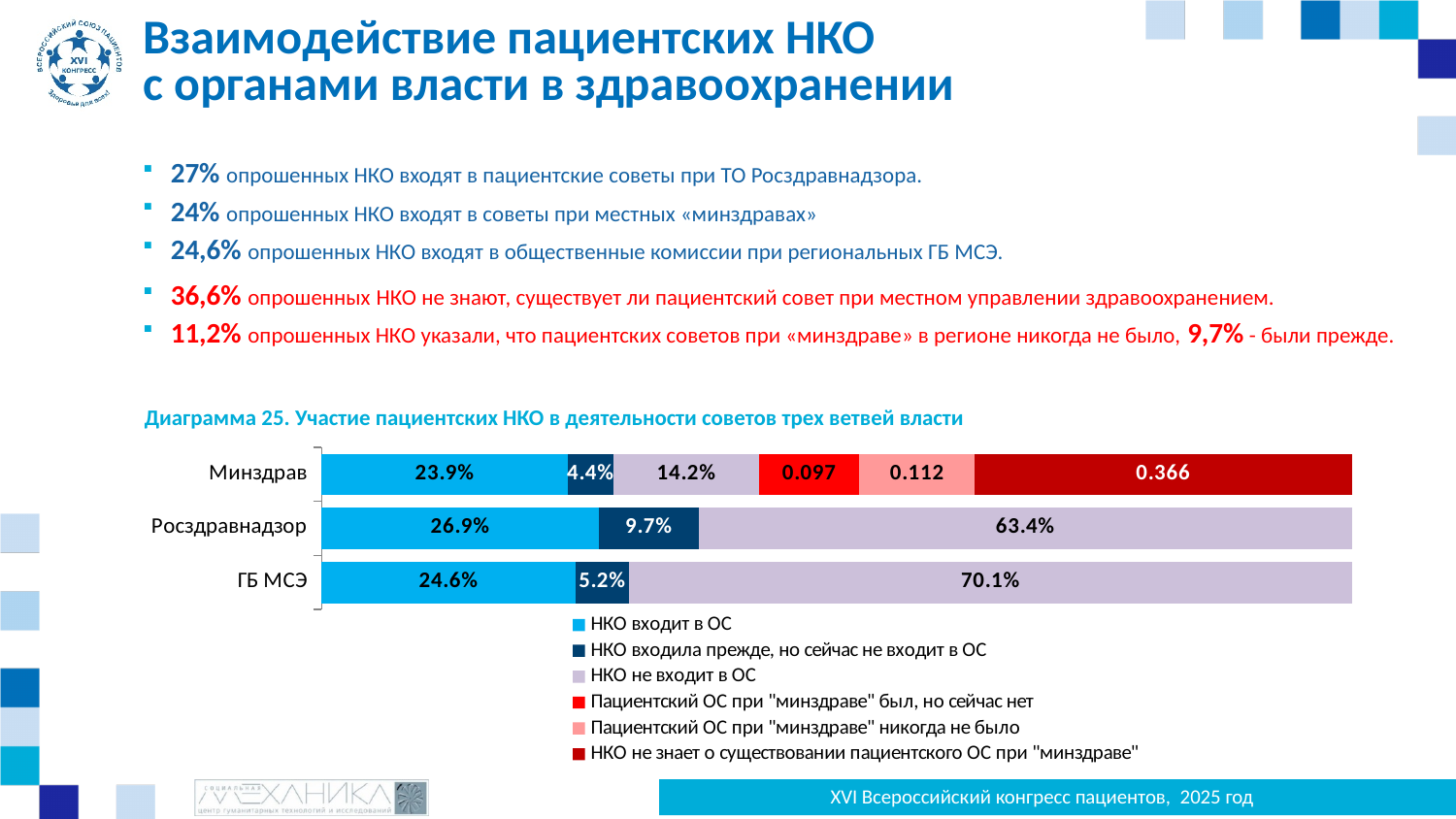
How many series does the chart's legend list? 6 What is the value of "НКО не знает о существовании пациентского ОС при "минздраве"" for Минздрав? 0.366 Which category has the highest value for "НКО входит в ОС"? Росздравнадзор How many categories are plotted on the chart's vertical axis? 3 What is the value of "НКО не входит в ОС" for ГБ МСЭ? 70.1% What is the value of "НКО входила прежде, но сейчас не входит в ОС" for Минздрав? 4.4% What is the difference between the "НКО не входит в ОС" values for ГБ МСЭ and Росздравнадзор? 6.7% Which is larger: the "НКО входила прежде, но сейчас не входит в ОС" value for Росздравнадзор or for ГБ МСЭ? Росздравнадзор What is the value of "НКО входит в ОС" for Росздравнадзор? 26.9% What is the title of the chart on the slide? Диаграмма 25. Участие пациентских НКО в деятельности советов трех ветвей власти Which category has the lowest value for "НКО входит в ОС"? Минздрав What kind of chart is shown under "Диаграмма 25"? stacked bar chart